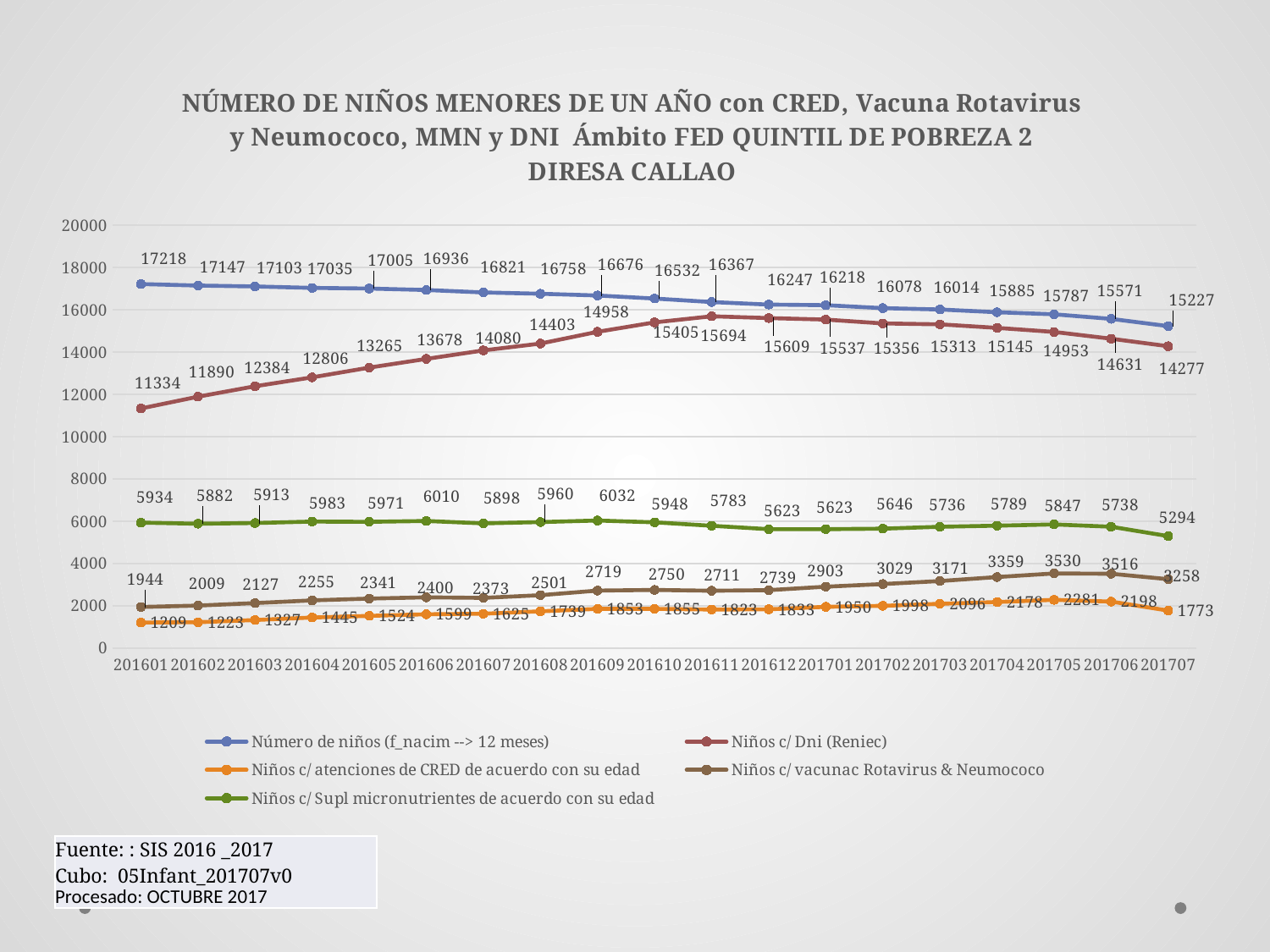
What is the value of 'Número de niños (f_nacim --> 12 meses)' at 201601? 17218 At 201705, which is larger: 'Niños c/ vacunac Rotavirus & Neumococo' or 'Niños c/ atenciones de CRED de acuerdo con su edad'? Niños c/ vacunac Rotavirus & Neumococo What is the difference between 'Número de niños (f_nacim --> 12 meses)' at 201601 and at 201707? 1991 In which period does 'Niños c/ vacunac Rotavirus & Neumococo' reach its highest value? 201705 In which period is 'Niños c/ atenciones de CRED de acuerdo con su edad' at its lowest value? 201601 How many series does the legend list? 5 How many periods are shown on the x axis? 19 What is the value of 'Niños c/ Supl micronutrientes de acuerdo con su edad' at 201609? 6032 In which period does 'Niños c/ Dni (Reniec)' reach its highest value? 201611 What is the value of 'Niños c/ Dni (Reniec)' at 201707? 14277 Is the value for 'Niños c/ Supl micronutrientes de acuerdo con su edad' at 201707 greater or less than 6000? less What kind of chart is shown on the slide? line chart